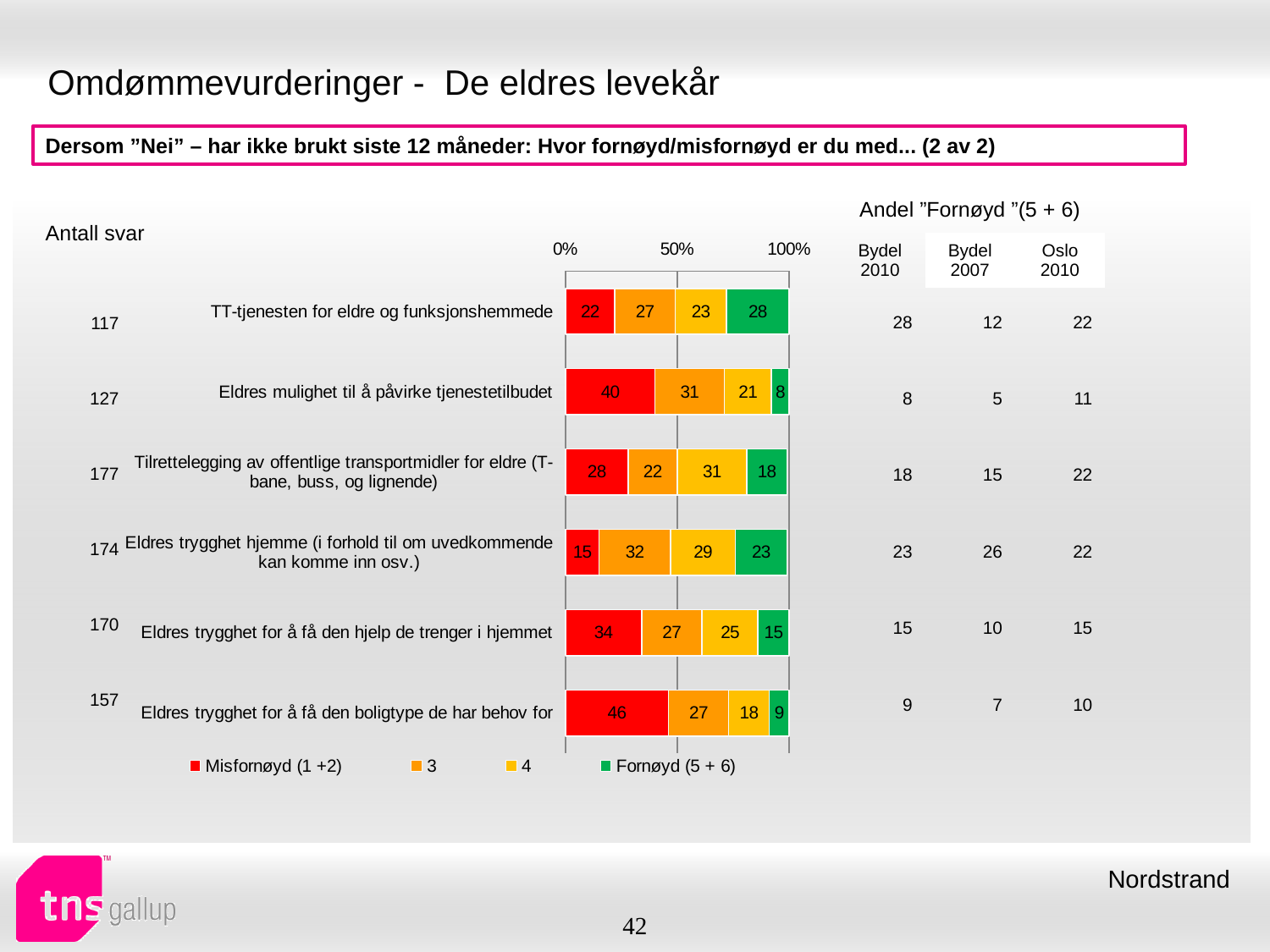
What is the value of the Fornøyd (5 + 6) segment for "TT-tjenesten for eldre og funksjonshemmede"? 28 Which colour represents the Fornøyd (5 + 6) series in the legend? Green How many categories are shown in the chart? 6 Which category has the lowest Fornøyd (5 + 6) value? Eldres mulighet til å påvirke tjenestetilbudet What is the difference between the Misfornøyd (1 +2) values for "Eldres mulighet til å påvirke tjenestetilbudet" and "Eldres trygghet hjemme (i forhold til om uvedkommende kan komme inn osv.)"? 25 Which is larger: the Fornøyd (5 + 6) value for "Eldres trygghet hjemme (i forhold til om uvedkommende kan komme inn osv.)" or for "Eldres trygghet for å få den hjelp de trenger i hjemmet"? Eldres trygghet hjemme (i forhold til om uvedkommende kan komme inn osv.) What is the value of the "4" segment for "Tilrettelegging av offentlige transportmidler for eldre (T-bane, buss, og lignende)"? 31 How many series does the legend list? 4 Which category has the highest Misfornøyd (1 +2) value? Eldres trygghet for å få den boligtype de har behov for What is the total of the stacked bar for "Eldres trygghet for å få den hjelp de trenger i hjemmet"? 101 What kind of chart is shown on the slide? Stacked bar chart What is the value of the Misfornøyd (1 +2) segment for "Eldres trygghet for å få den boligtype de har behov for"? 46